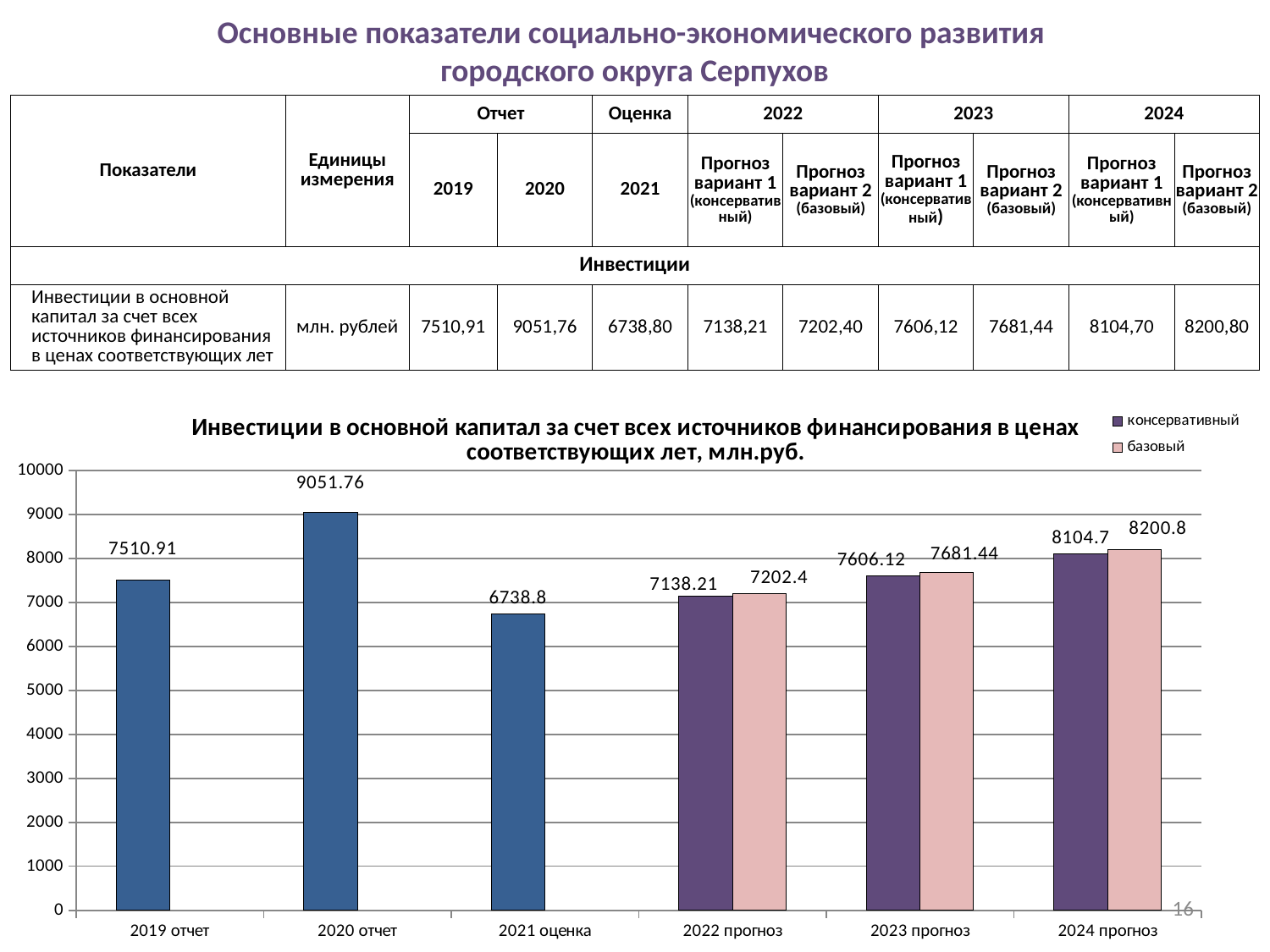
What is the difference between the базовый and консервативный values for 2024 прогноз? 96.1 How many series does the legend list? 2 Is the value for 2021 оценка greater or less than 7000? less What is the difference between the values for 2020 отчет and 2019 отчет? 1540.85 Which category has the highest value? 2020 отчет What kind of chart is shown? bar chart What is the value for 2020 отчет? 9051.76 What is the консервативный value for 2024 прогноз? 8104.7 What is the базовый value for 2022 прогноз? 7202.4 Which is larger: the консервативный value for 2023 прогноз or the базовый value for 2022 прогноз? консервативный value for 2023 прогноз Which category has the lowest value? 2021 оценка How many categories are shown on the x axis? 6